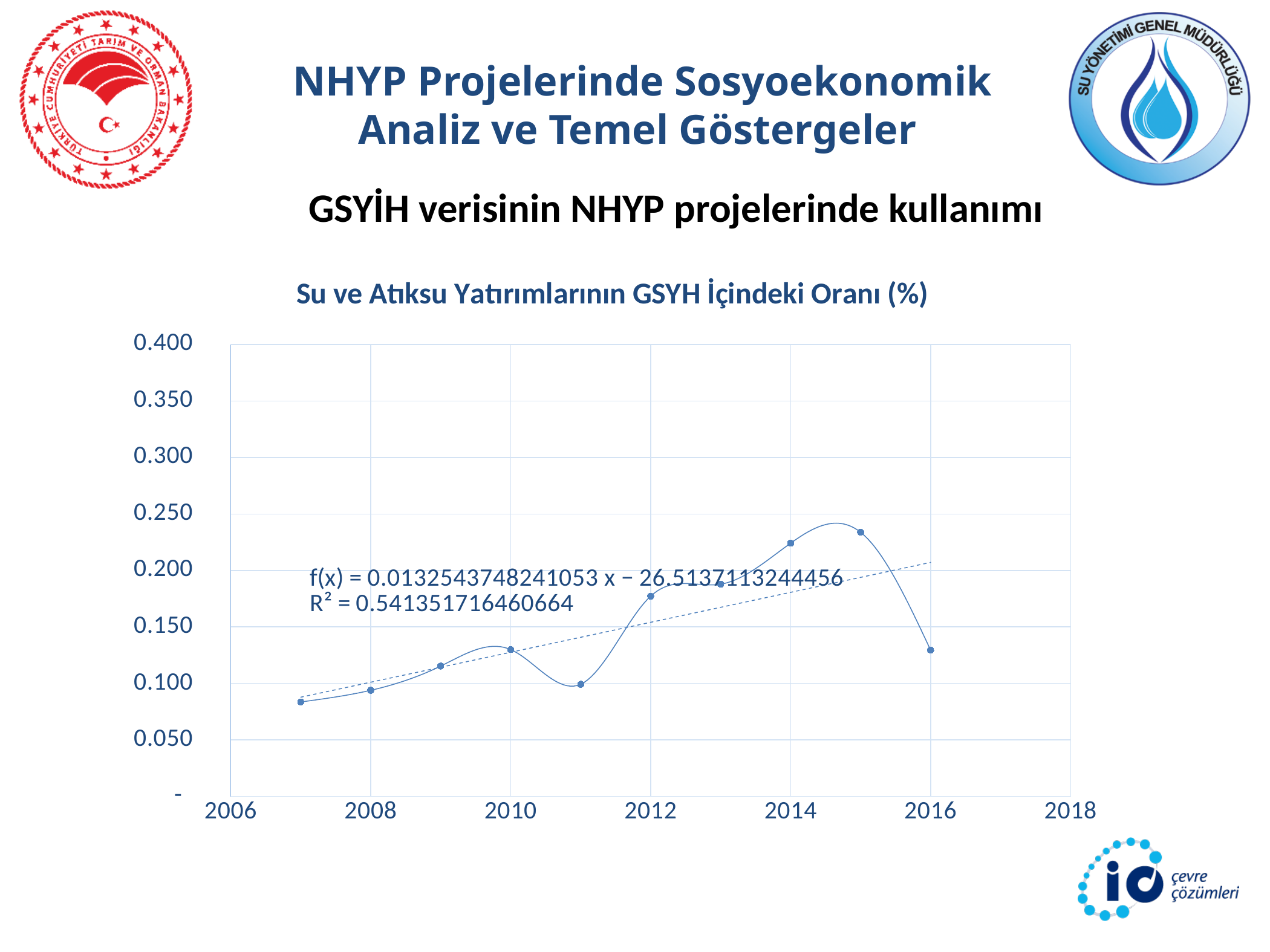
Is the value for 2016 greater or less than 0.100? greater Which year has the larger value, 2010 or 2012? 2012 Is the value for 2012 greater or less than 0.150? greater Is the value for 2014 greater or less than 0.200? greater What R² value is shown for the trendline on the chart? 0.541351716460664 Which year has the highest value on the chart? 2015 What kind of chart is shown on the slide? line chart Which year has the lowest value on the chart? 2007 How many data points are plotted on the chart? 10 What is the title of the chart? Su ve Atıksu Yatırımlarının GSYH İçindeki Oranı (%) Do the values rise or fall from 2011 to 2015? rise